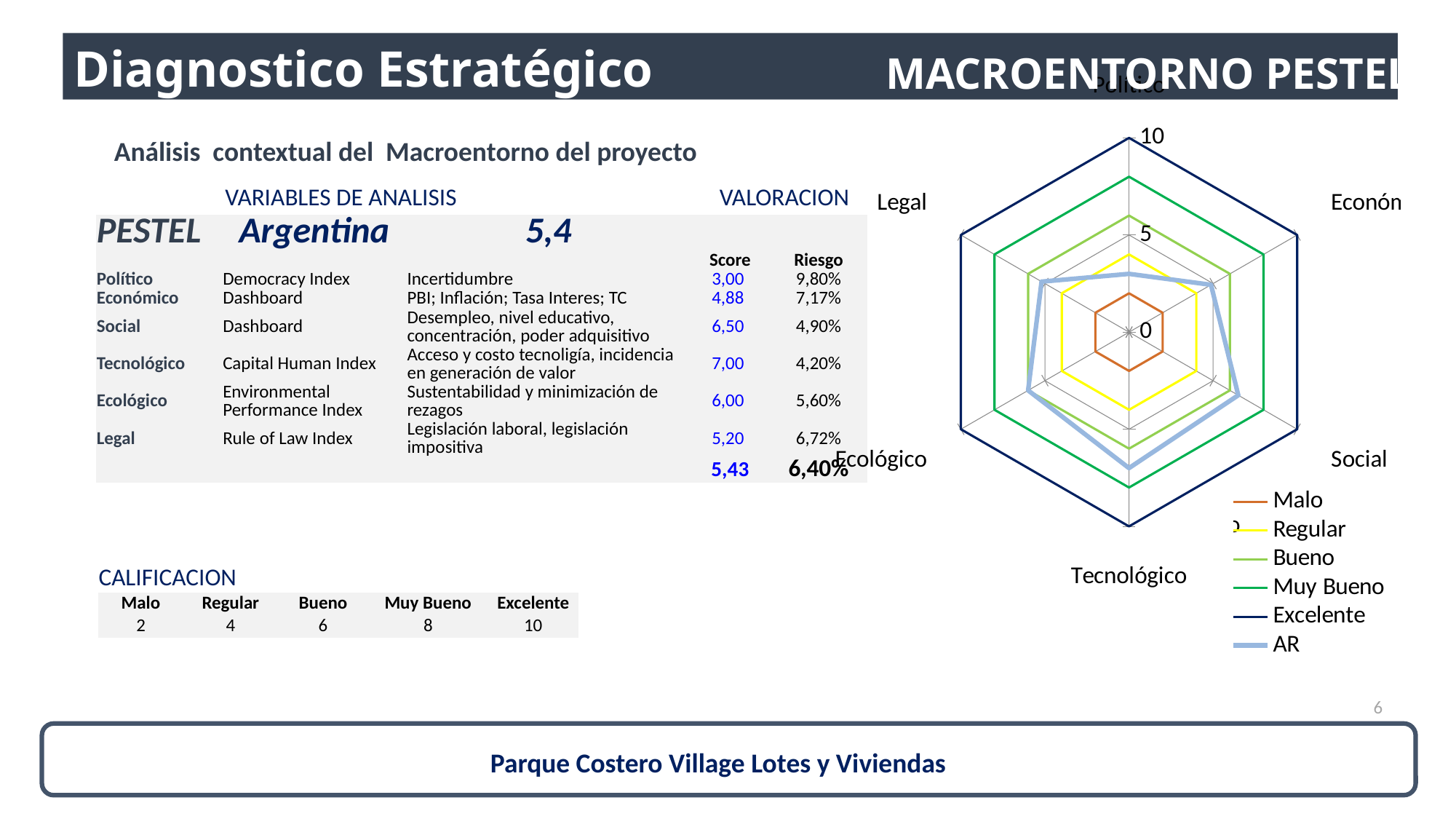
What kind of chart is shown on the right of the slide? Radar chart On the radar chart, is the AR value for Ecológico greater or less than 5? greater On the radar chart, is the AR value for Tecnológico greater or less than 5? greater On the radar chart, is the AR value for Político greater or less than 5? less Which series on the radar chart is drawn as the innermost hexagon? Malo Which series forms the outermost hexagon on the radar chart? Excelente How many series does the legend of the radar chart list? 6 What is the highest value shown on the radar chart's axis scale? 10 For the AR series on the radar chart, which is larger: the value for Tecnológico or the value for Político? Tecnológico How many axes (categories) does the radar chart have? 6 On which axis does the AR series reach its lowest value on the radar chart? Político